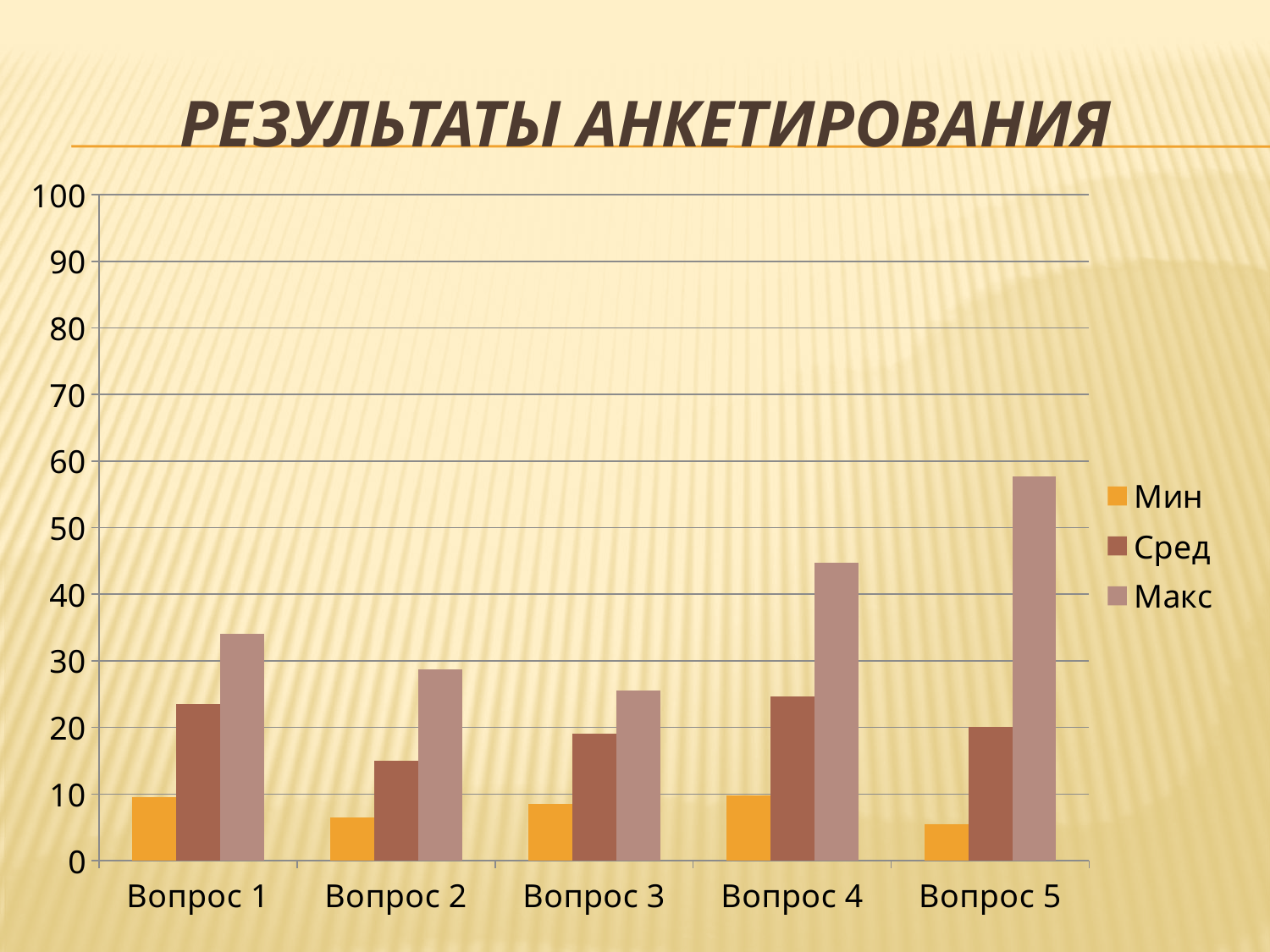
Which is larger, the Сред value for Вопрос 1 or the Сред value for Вопрос 2? Вопрос 1 Is the Сред value for Вопрос 2 greater or less than 20? less Is the Макс value for Вопрос 5 greater or less than 50? greater How many series does the legend list? 3 Which category has the lowest value for the Сред series? Вопрос 2 What kind of chart is shown on the slide? bar chart What is the title of the chart? РЕЗУЛЬТАТЫ АНКЕТИРОВАНИЯ Which category has the highest value for the Макс series? Вопрос 5 How many categories are shown on the x axis? 5 Which category has the lowest value for the Макс series? Вопрос 3 Which category has the lowest value for the Мин series? Вопрос 5 Which series is shown in orange in the legend? Мин